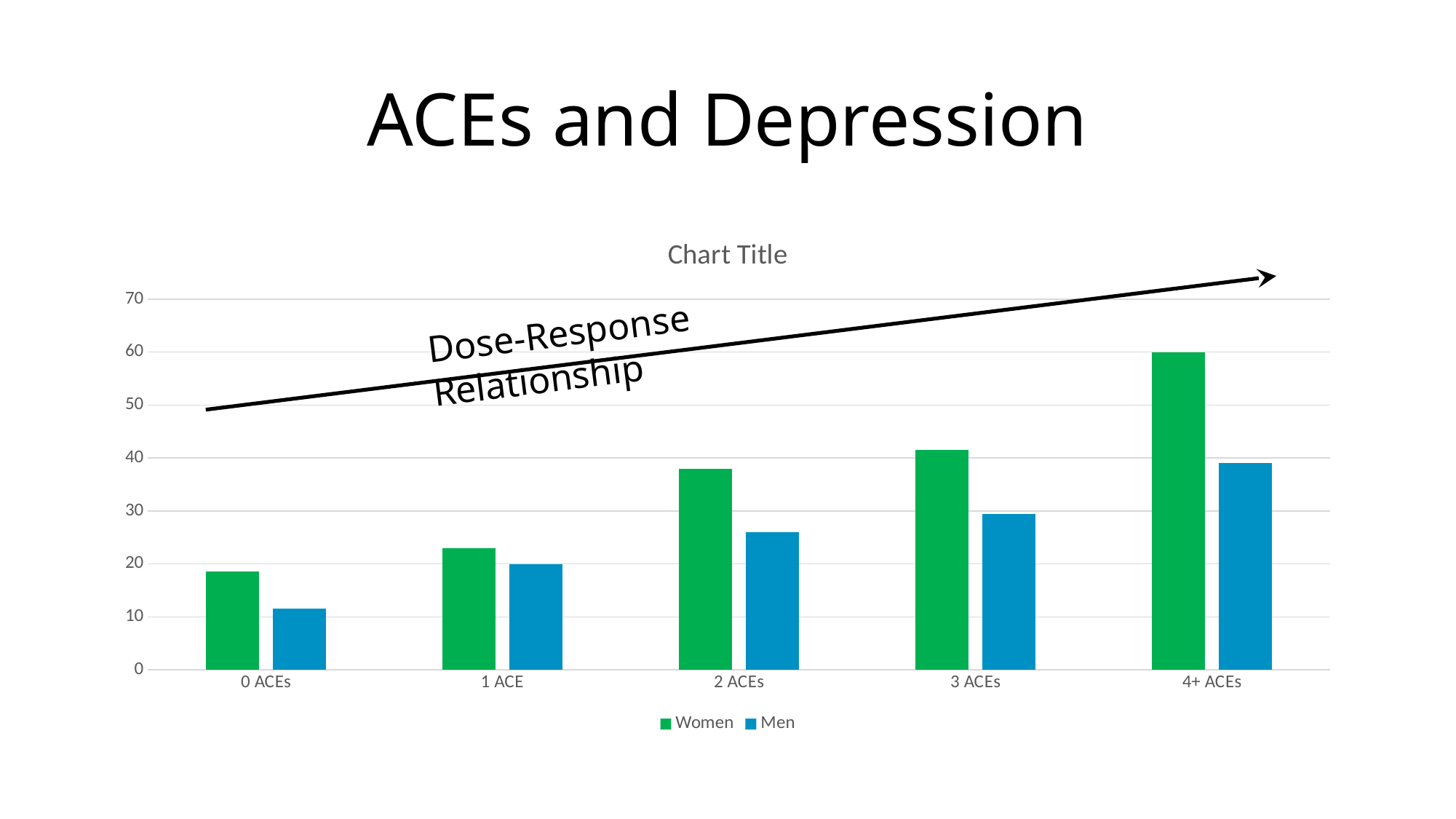
Is the value for Women at 0 ACEs greater or less than 20? less Is the value for Men at 2 ACEs greater or less than 30? less Which ACE category has the highest value for Women? 4+ ACEs Is the value for Women at 2 ACEs greater or less than 40? less Which ACE category has the lowest value for Men? 0 ACEs Do the values for Women rise or fall as the number of ACEs increases along the x axis? rise How many ACE categories are shown on the x axis? 5 What kind of chart is shown on the slide? bar chart What are the two entries in the chart's legend? Women and Men How many series does the legend list? 2 What text is written along the arrow drawn over the chart? Dose-Response Relationship At 2 ACEs, which series has the larger value, Women or Men? Women